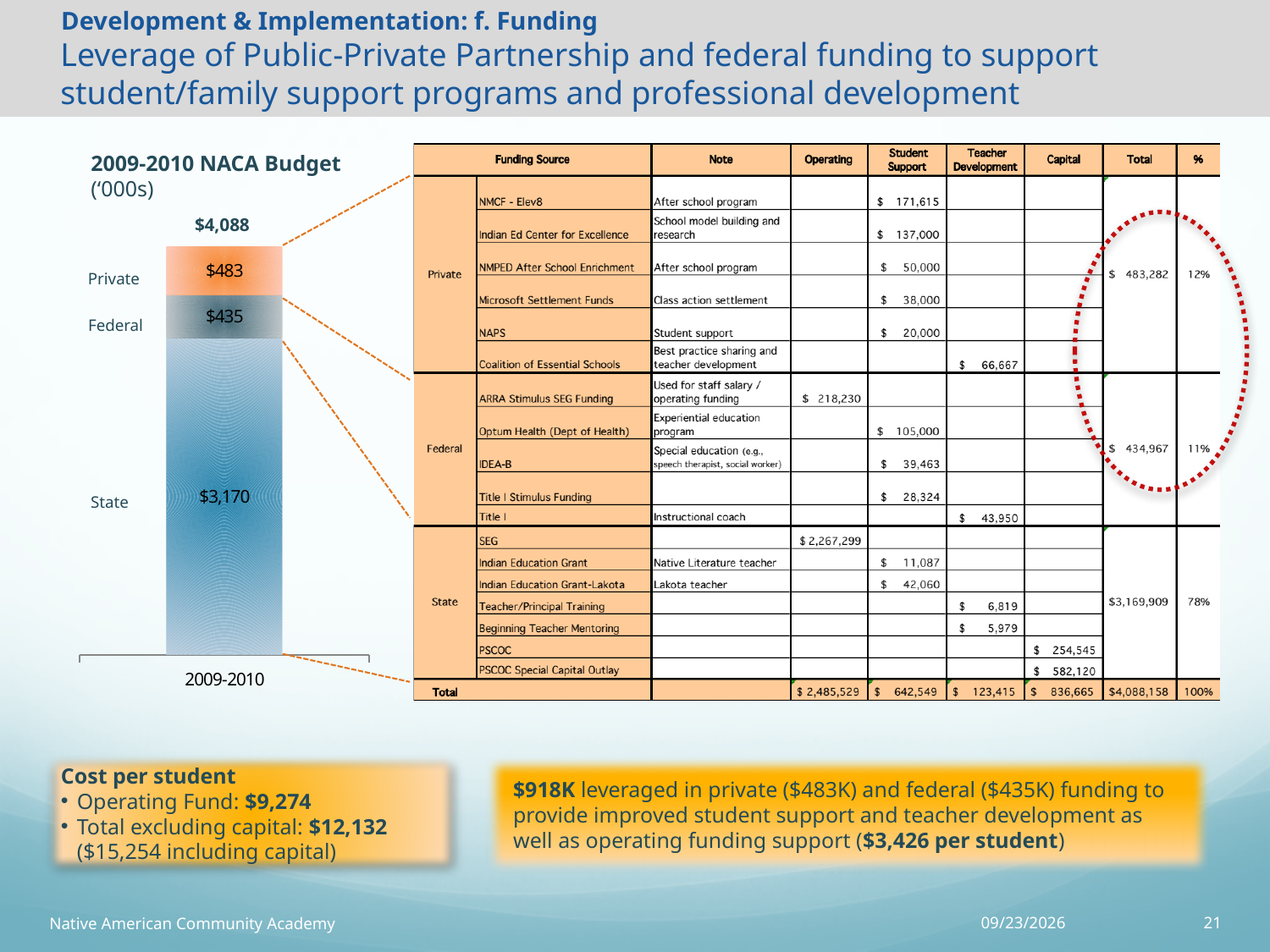
In the 2009-2010 NACA Budget chart, what is the value of the Private segment? $483 How many segments make up the stacked bar in the 2009-2010 NACA Budget chart? 3 In the 2009-2010 NACA Budget chart, what is the value of the Federal segment? $435 What type of chart is shown on the left of the slide? Stacked bar chart In the 2009-2010 NACA Budget chart, what is the value of the State segment? $3,170 In the 2009-2010 NACA Budget chart, what is the total of the stacked bar? $4,088 In the 2009-2010 NACA Budget chart, which is larger, the Private segment or the Federal segment? Private What category label appears on the x axis of the 2009-2010 NACA Budget chart? 2009-2010 What is the title of the chart on the slide? 2009-2010 NACA Budget In the 2009-2010 NACA Budget chart, which segment is the largest? State In the 2009-2010 NACA Budget chart, what is the difference between the Private and Federal segments? $48 In the 2009-2010 NACA Budget chart, which segment is the smallest? Federal